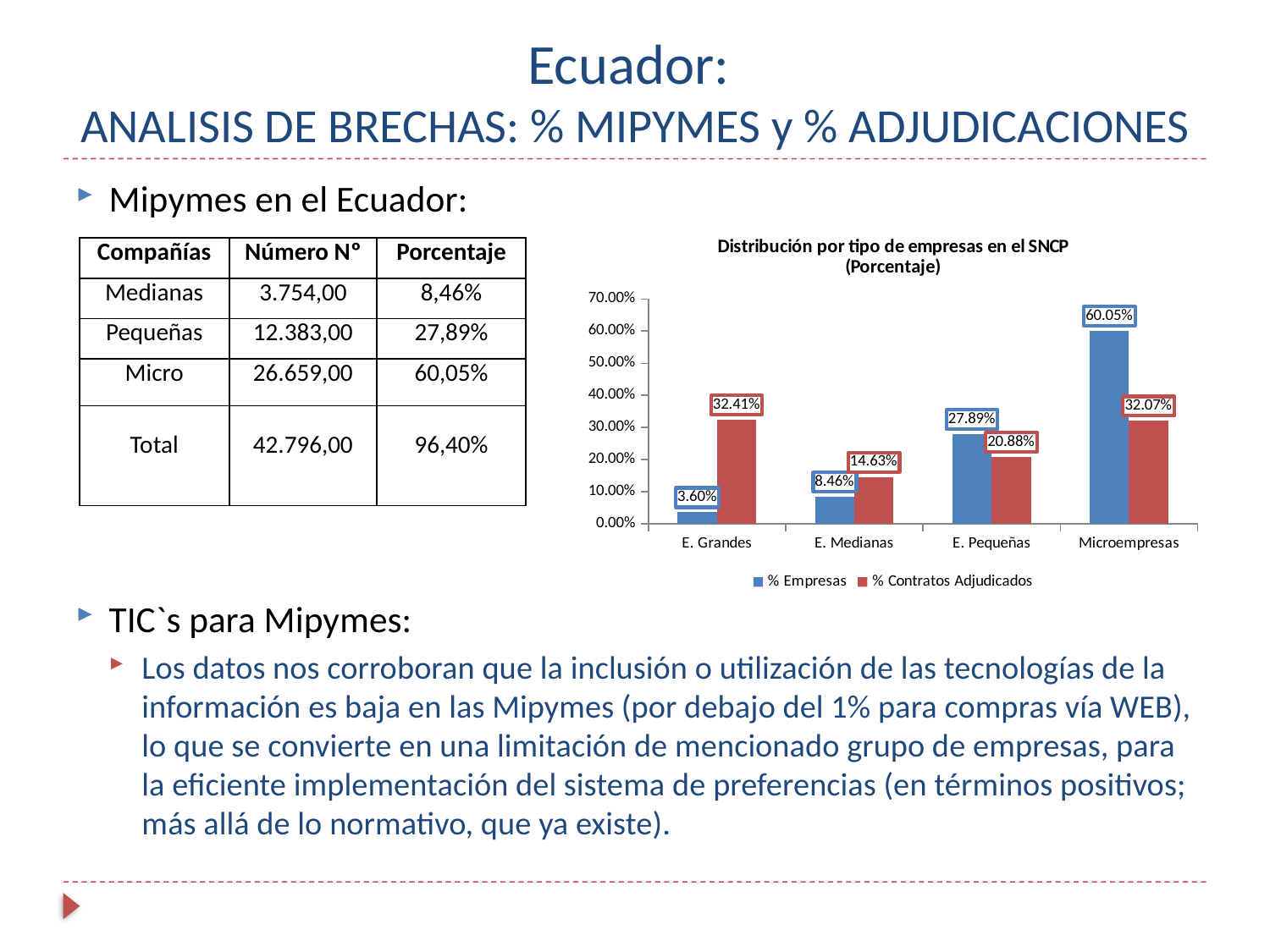
Which category has the highest % Empresas value? Microempresas What type of chart is shown on the slide? Bar chart Which category has the lowest % Contratos Adjudicados value? E. Medianas How many series does the chart legend list? 2 What is the % Contratos Adjudicados value for E. Grandes? 32.41% How many company categories are shown on the x axis of the chart? 4 What is the title of the chart? Distribución por tipo de empresas en el SNCP (Porcentaje) For E. Pequeñas, which is larger: % Empresas or % Contratos Adjudicados? % Empresas Does the % Empresas value for Microempresas rise or fall compared with E. Pequeñas? Rise What is the difference between % Contratos Adjudicados and % Empresas for E. Grandes? 28.81 percentage points What is the % Empresas value for E. Medianas? 8.46% What is the % Empresas value for Microempresas? 60.05%